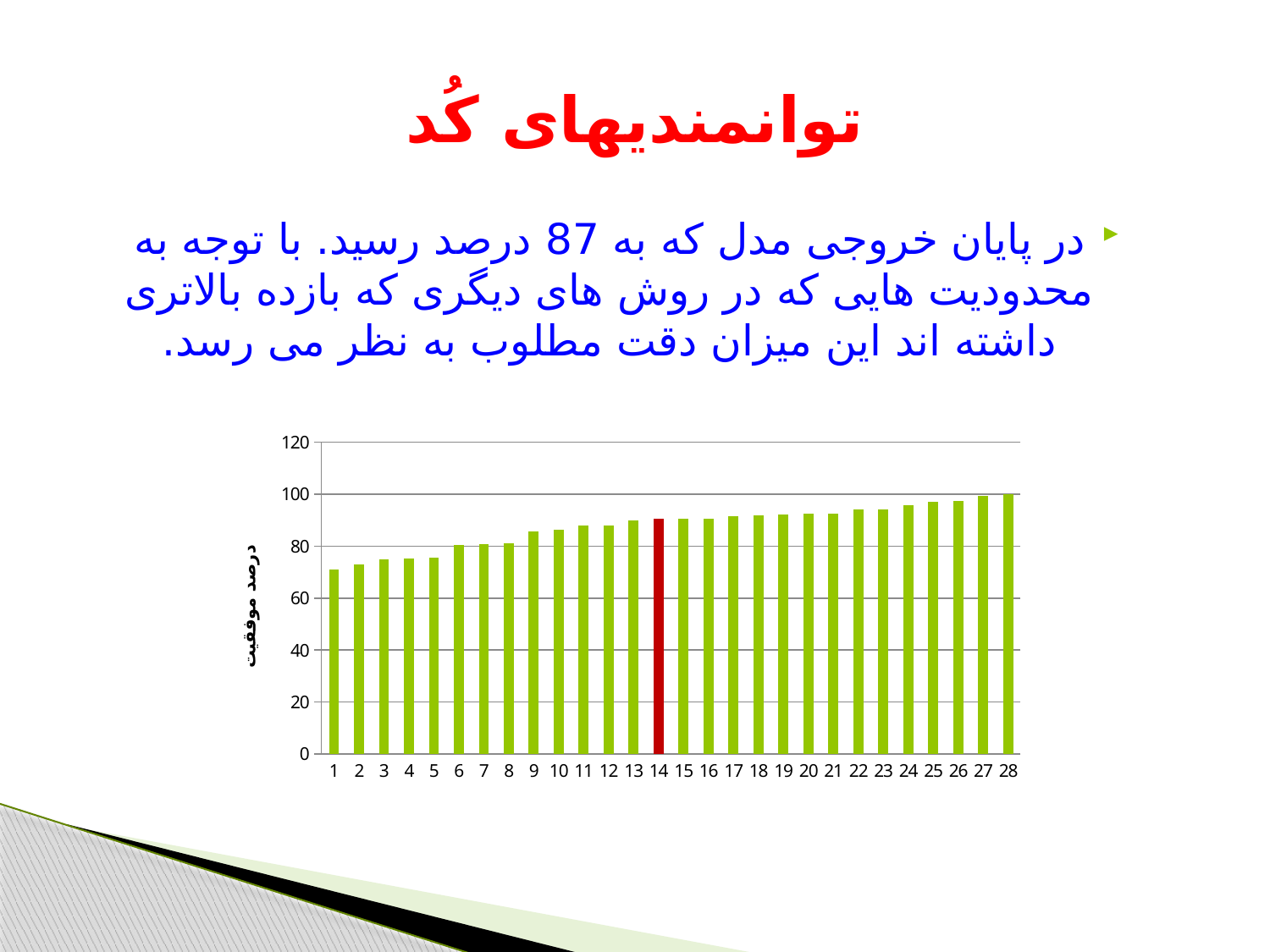
Which category has the lowest bar on the chart? 1 What is the title of the vertical axis? درصد موفقیت How many bars (categories) are plotted on the chart? 28 Is the value for category 1 greater or less than 80? less Which has the larger value, category 28 or category 1? 28 What kind of chart is shown on the slide? bar chart Is the value for category 20 greater or less than 100? less Which bar on the chart is coloured red instead of green? 14 Is the value for category 14 greater or less than 80? greater Do the bar values rise or fall as you move from category 1 to category 28 along the x axis? rise